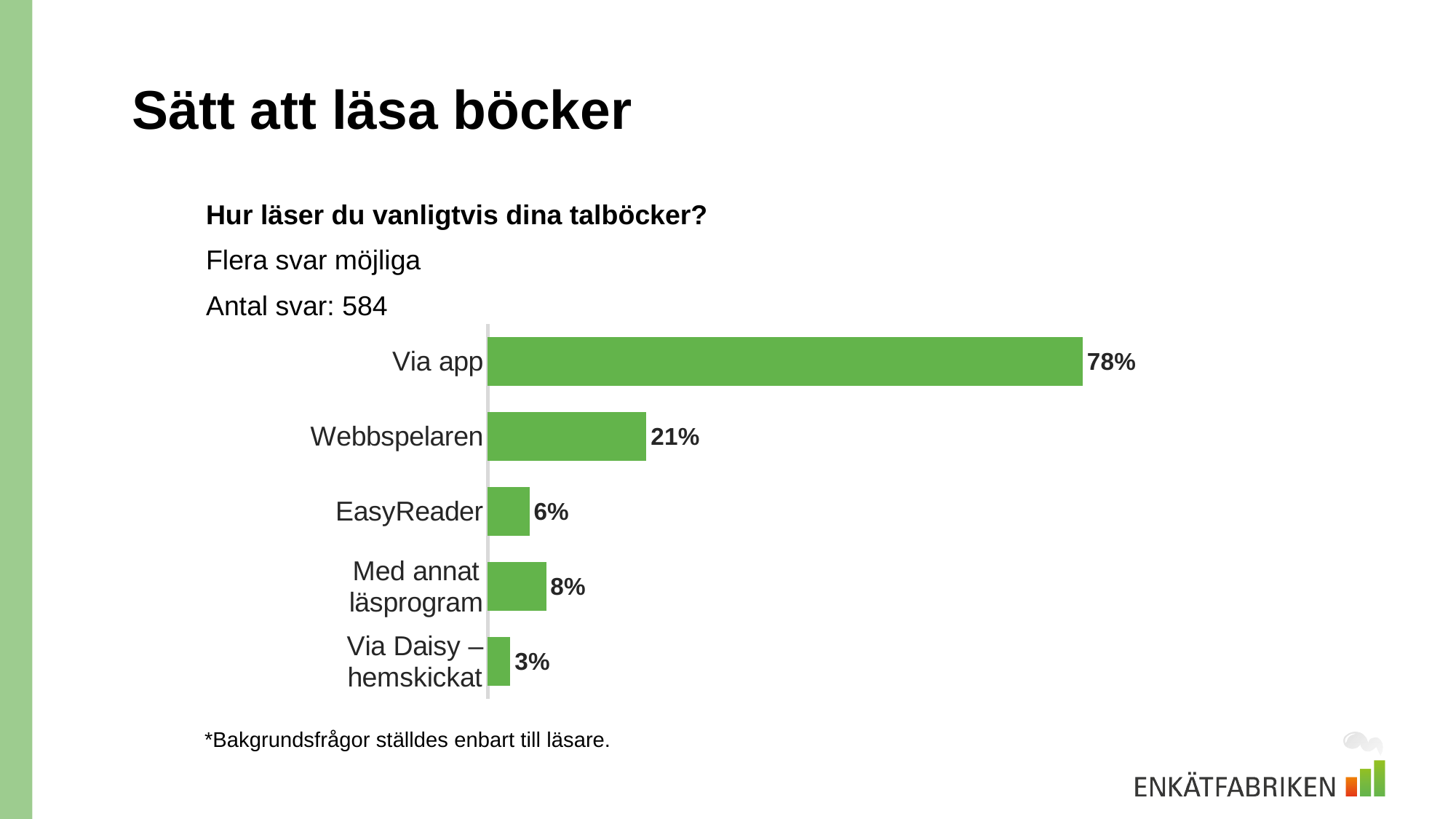
What is the value shown for 'Via Daisy – hemskickat'? 3% Which category has the lowest value? Via Daisy – hemskickat What kind of chart is shown on the slide? Bar chart Which is larger, the value for EasyReader or for 'Med annat läsprogram'? Med annat läsprogram What is the value shown for EasyReader? 6% What is the difference between the values for Via app and Webbspelaren? 57% What is the value shown for 'Med annat läsprogram'? 8% Which category has the highest value? Via app What is the value shown for Webbspelaren? 21% How many categories are shown in the chart? 5 What percentage of respondents read their talking books via app? 78% How many responses (Antal svar) does the chart report? 584